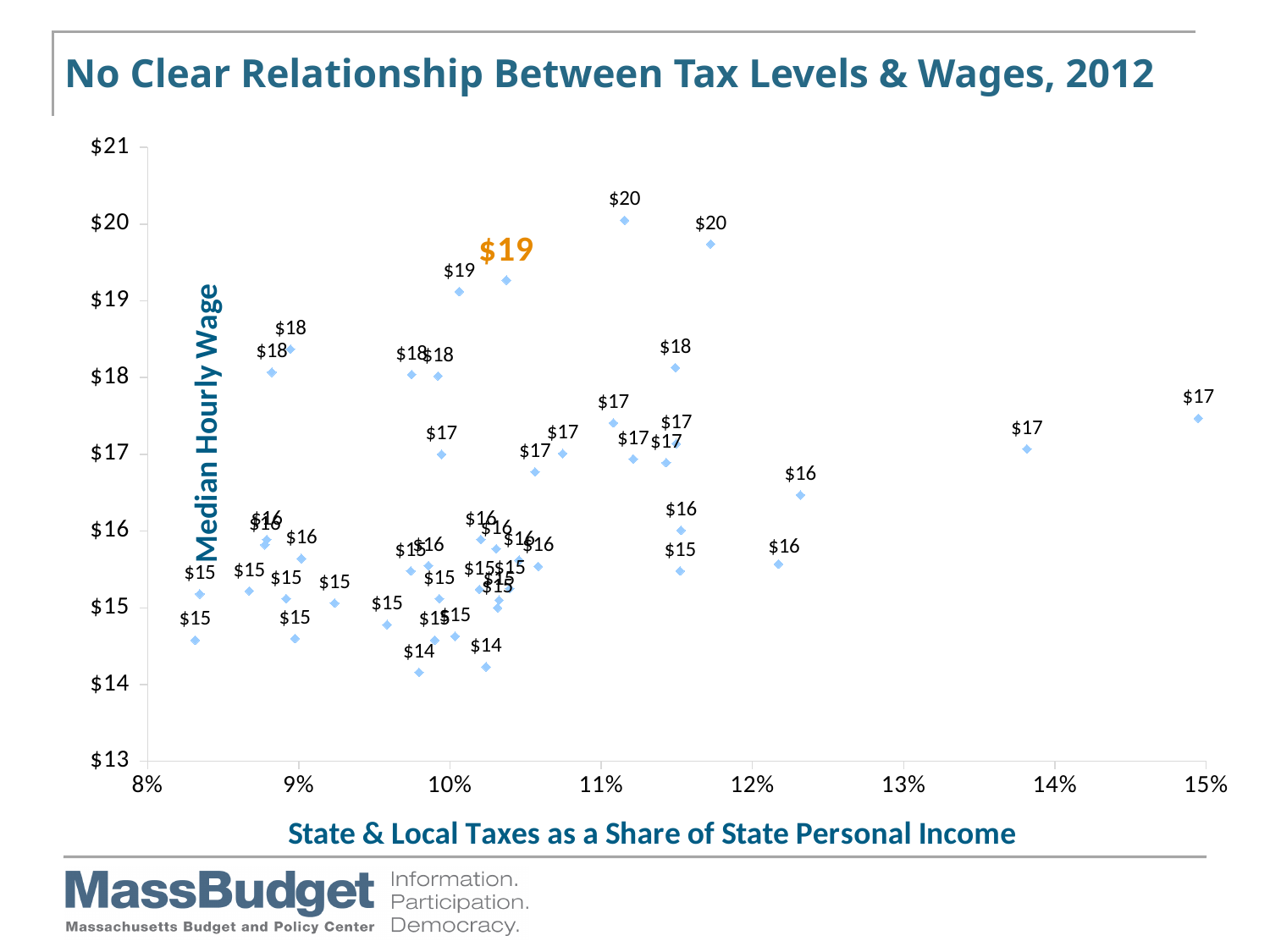
What is the median hourly wage labeled for the point with the highest tax share (farthest right, near 15%)? $17 What is the label of the vertical axis? Median Hourly Wage What kind of chart is shown on the slide? scatter chart Is the median hourly wage for the point near 12.3% on the x axis greater or less than $16? greater What value is shown on the orange highlighted data label? $19 What is the title of the chart? No Clear Relationship Between Tax Levels & Wages, 2012 What is the lowest median hourly wage labeled on the chart? $14 What is the highest median hourly wage labeled on the chart? $20 How many points are labeled $14? 2 How many points are labeled $20? 2 Do median hourly wages clearly rise or fall as the tax share increases along the x axis? no clear relationship Is the median hourly wage for the point near 14% on the x axis greater or less than $18? less